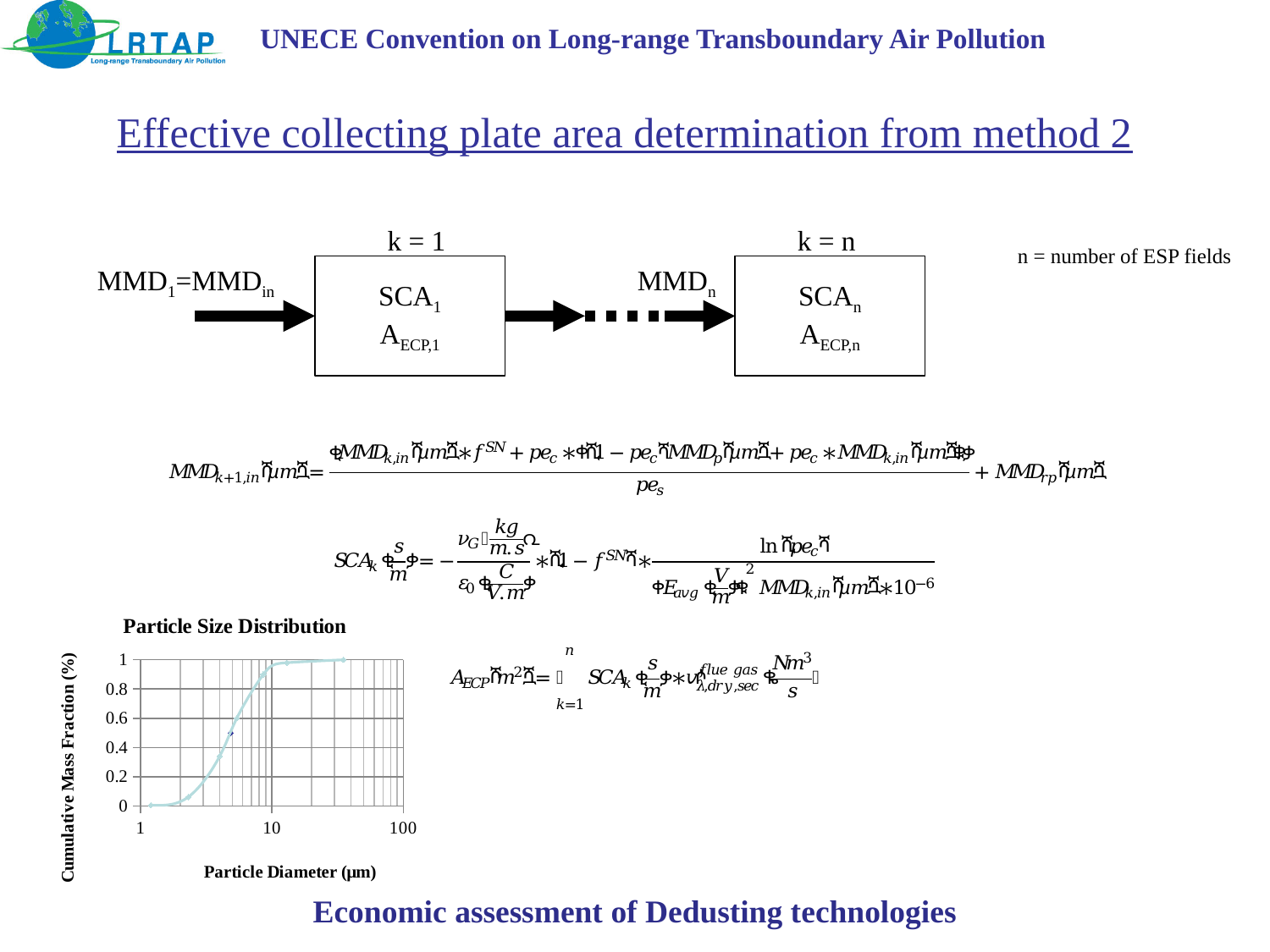
In the Particle Size Distribution chart, does the cumulative mass fraction rise or fall as particle diameter increases? rise What is the largest tick value shown on the x axis of the Particle Size Distribution chart? 100 In the Particle Size Distribution chart, is the cumulative mass fraction at a particle diameter of 5 µm greater or less than 0.2? greater What kind of chart is the Particle Size Distribution chart? line chart In the Particle Size Distribution chart, is the cumulative mass fraction at a particle diameter of 2 µm greater or less than 0.2? less What is the title of the chart on the slide? Particle Size Distribution What is the label of the x axis of the Particle Size Distribution chart? Particle Diameter (µm) In the Particle Size Distribution chart, which is larger: the cumulative mass fraction at 3 µm or at 10 µm? 10 µm